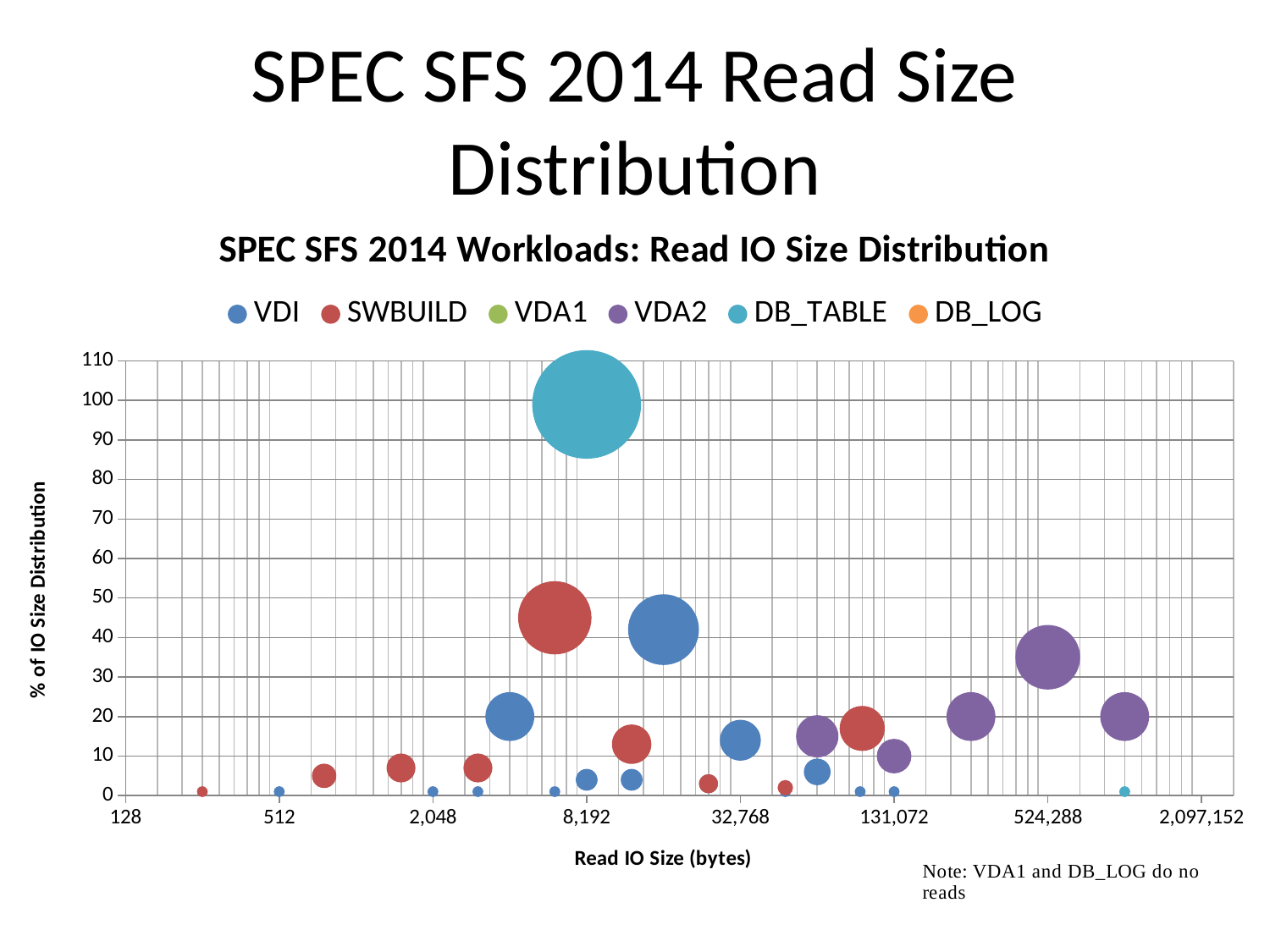
According to the note on the slide, which two workloads do no reads? VDA1 and DB_LOG Which series has the highest plotted value on the chart? DB_TABLE Is the value for DB_TABLE at 8,192 bytes greater or less than 80? greater How many series does the legend list? 6 Is the value for VDI at 4,096 bytes greater or less than 30? less Which is larger: the VDA2 value at 524,288 bytes or the VDA2 value at 1,048,576 bytes? 524,288 bytes Is the value for VDI at 4,096 bytes greater or less than 10? greater What kind of chart is shown on the slide? Bubble chart Which is larger: the DB_TABLE value at 8,192 bytes or the largest SWBUILD value? DB_TABLE at 8,192 bytes What is the title of the chart? SPEC SFS 2014 Workloads: Read IO Size Distribution